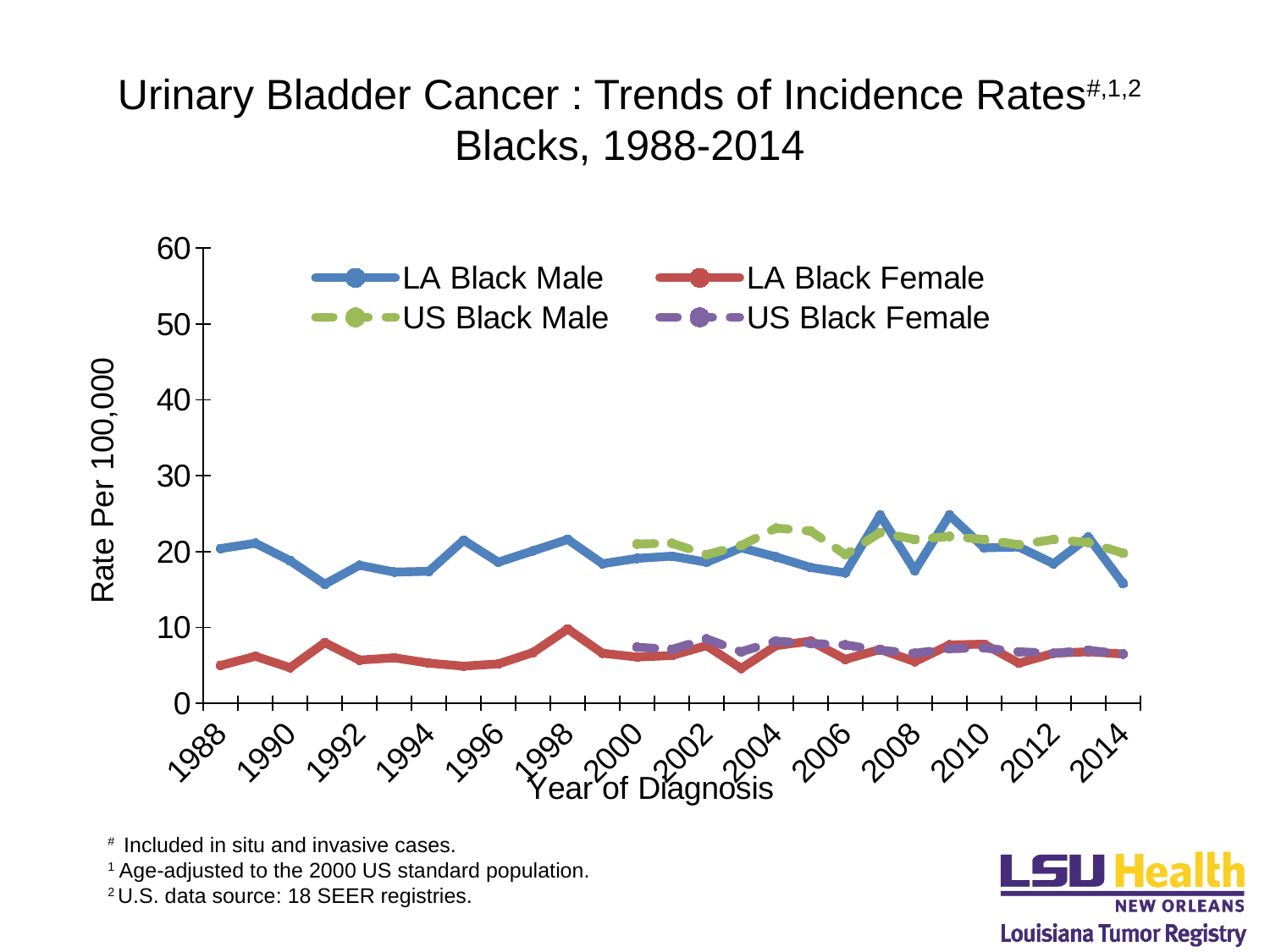
What is the title of the y axis? Rate Per 100,000 In 2014, which is larger: the value for LA Black Male or LA Black Female? LA Black Male Is the value for US Black Male in 2004 greater or less than 20? greater Is the value for US Black Female in 2014 greater or less than 10? less Is the value for LA Black Female in 1998 greater or less than 20? less How many year labels are shown on the x axis? 14 In which year does the LA Black Female line reach its highest value? 1998 How many series does the legend list? 4 What kind of chart is shown on the slide? line chart Does the LA Black Male line end lower or higher in 2014 than it started in 1988? lower